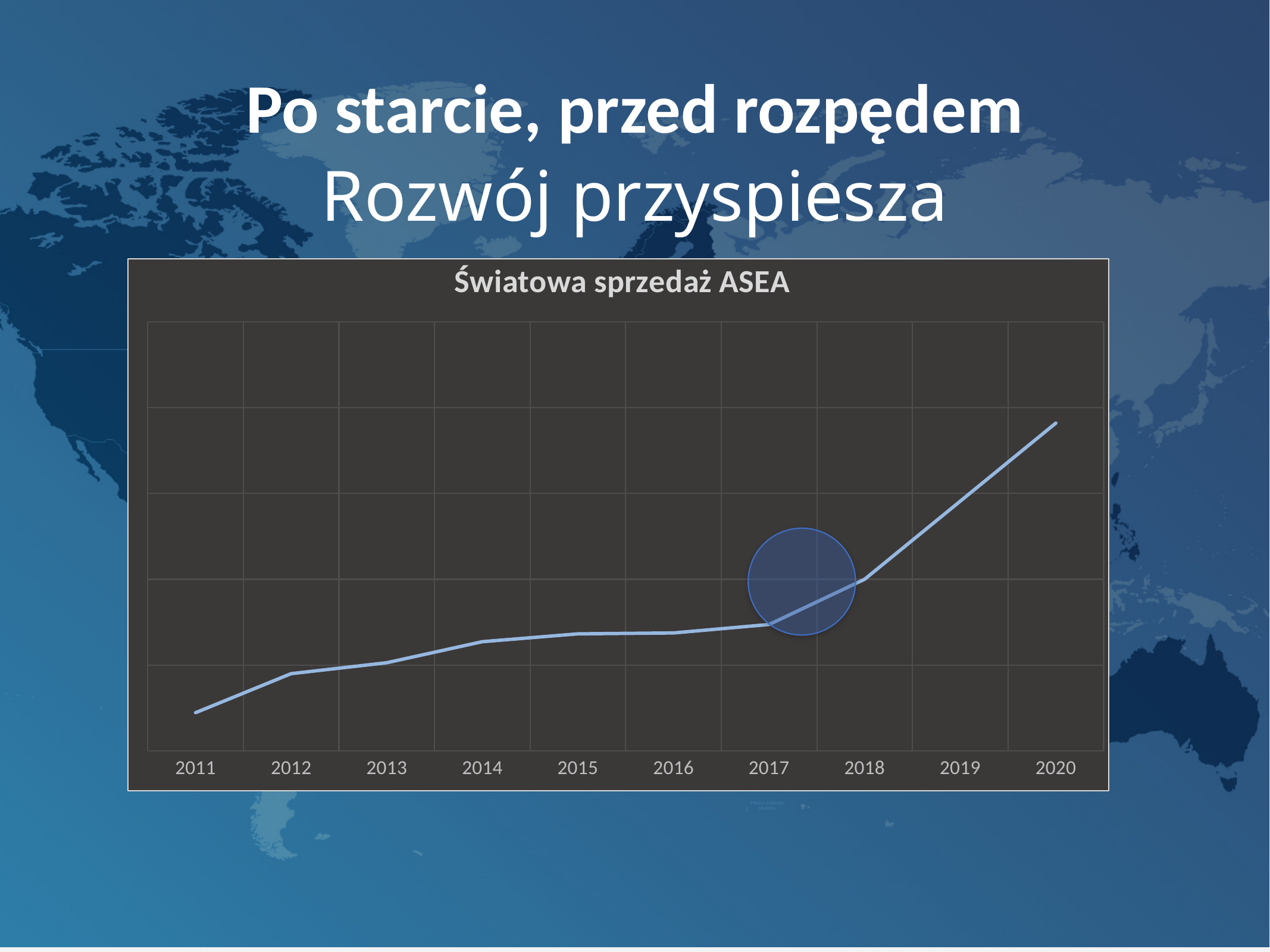
What is the title of the chart? Światowa sprzedaż ASEA Which is larger, the value for 2011 or the value for 2014? 2014 How many years are shown on the x axis of the chart? 10 Do the values in the chart rise or fall from 2011 to 2020? rise Which is larger, the value for 2012 or the value for 2018? 2018 Which year has the highest value in the chart? 2020 What kind of chart is shown on the slide? line chart Does the line rise more steeply before 2018 or after 2018? after 2018 Which is larger, the value for 2020 or the value for 2017? 2020 Which year has the lowest value in the chart? 2011 What is the first year shown on the x axis? 2011